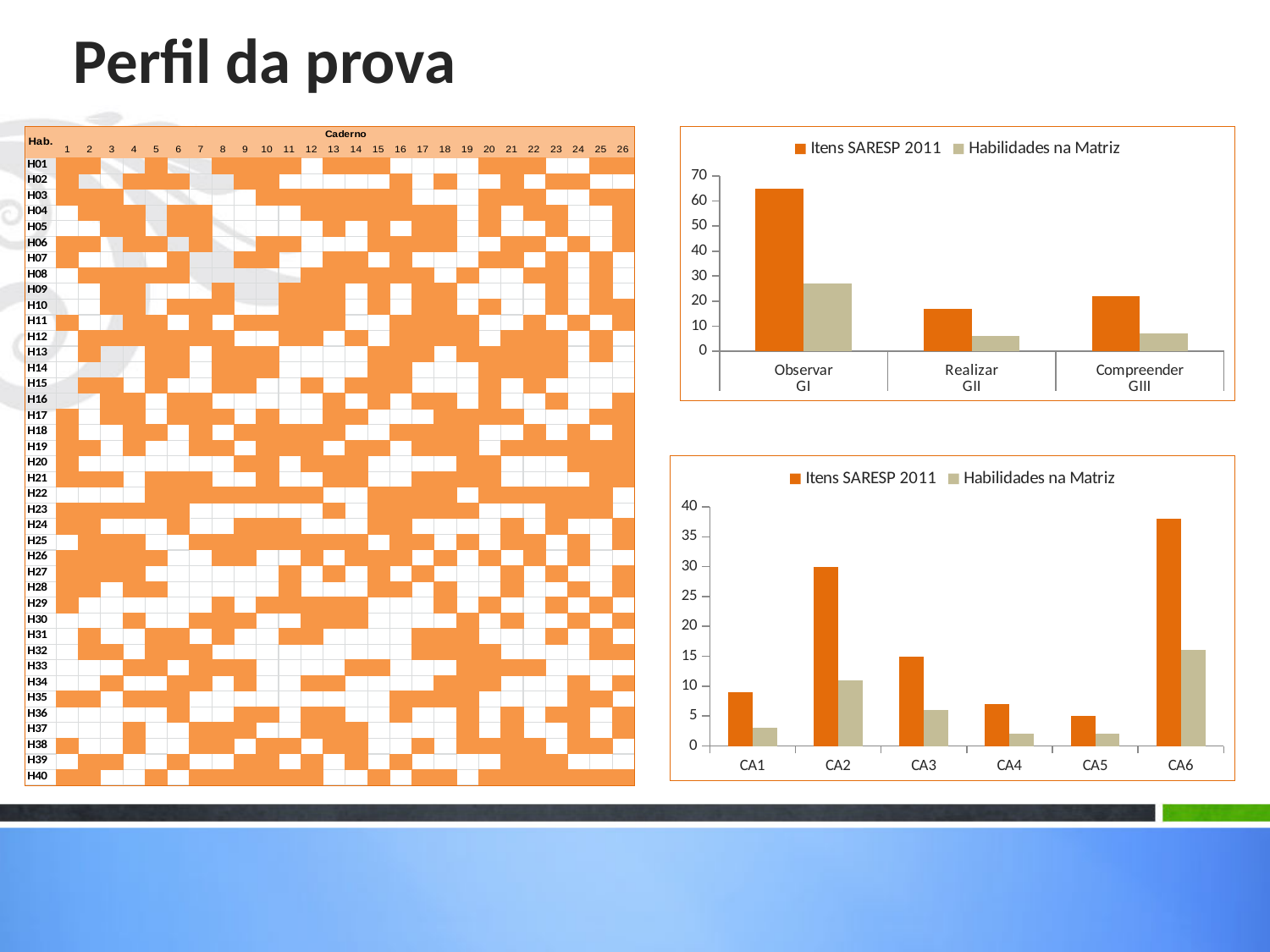
In the top right chart, is the Habilidades na Matriz value for Compreender GIII greater or less than 10? less In the bottom right chart, how many categories are shown on the x axis? 6 In the top right chart, which category has the lowest value for Habilidades na Matriz? Realizar GII In the top right chart, is the Itens SARESP 2011 value for Observar GI greater or less than 60? greater In the top right chart, which category has the highest value for Itens SARESP 2011? Observar GI In the top right chart, how many categories are shown on the x axis? 3 In the bottom right chart, is the Itens SARESP 2011 value for CA2 greater or less than 25? greater In the bottom right chart, which category has the highest value for Itens SARESP 2011? CA6 In the bottom right chart, which category has the lowest value for Itens SARESP 2011? CA5 In the top right chart, how many series does the legend list? 2 What type of chart is the bottom right chart? Bar chart In the bottom right chart, which is larger for Habilidades na Matriz: CA2 or CA3? CA2